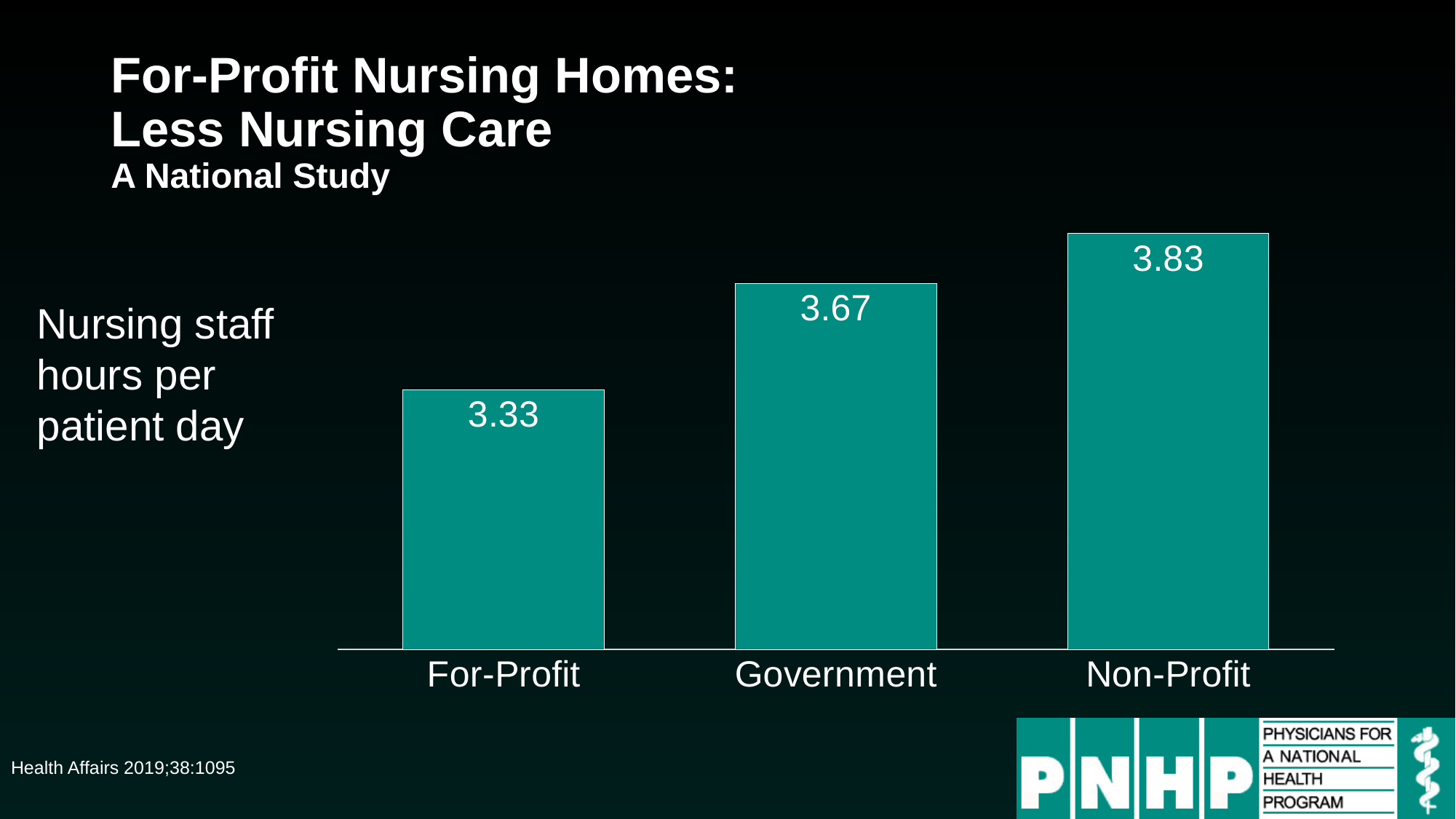
Which category has the highest nursing staff hours per patient day? Non-Profit Which is larger, the value for Government or the value for For-Profit? Government Do the values rise or fall from left to right across the categories? Rise What kind of chart is shown on the slide? Bar chart What quantity does the chart measure, according to the label on the left? Nursing staff hours per patient day What is the value for Government nursing homes? 3.67 Which category has the lowest nursing staff hours per patient day? For-Profit How many categories are shown in the chart? 3 What is the difference between the Non-Profit and For-Profit values? 0.50 What is the difference between the Government and For-Profit values? 0.34 What is the value for Non-Profit nursing homes? 3.83 What is the value for For-Profit nursing homes? 3.33